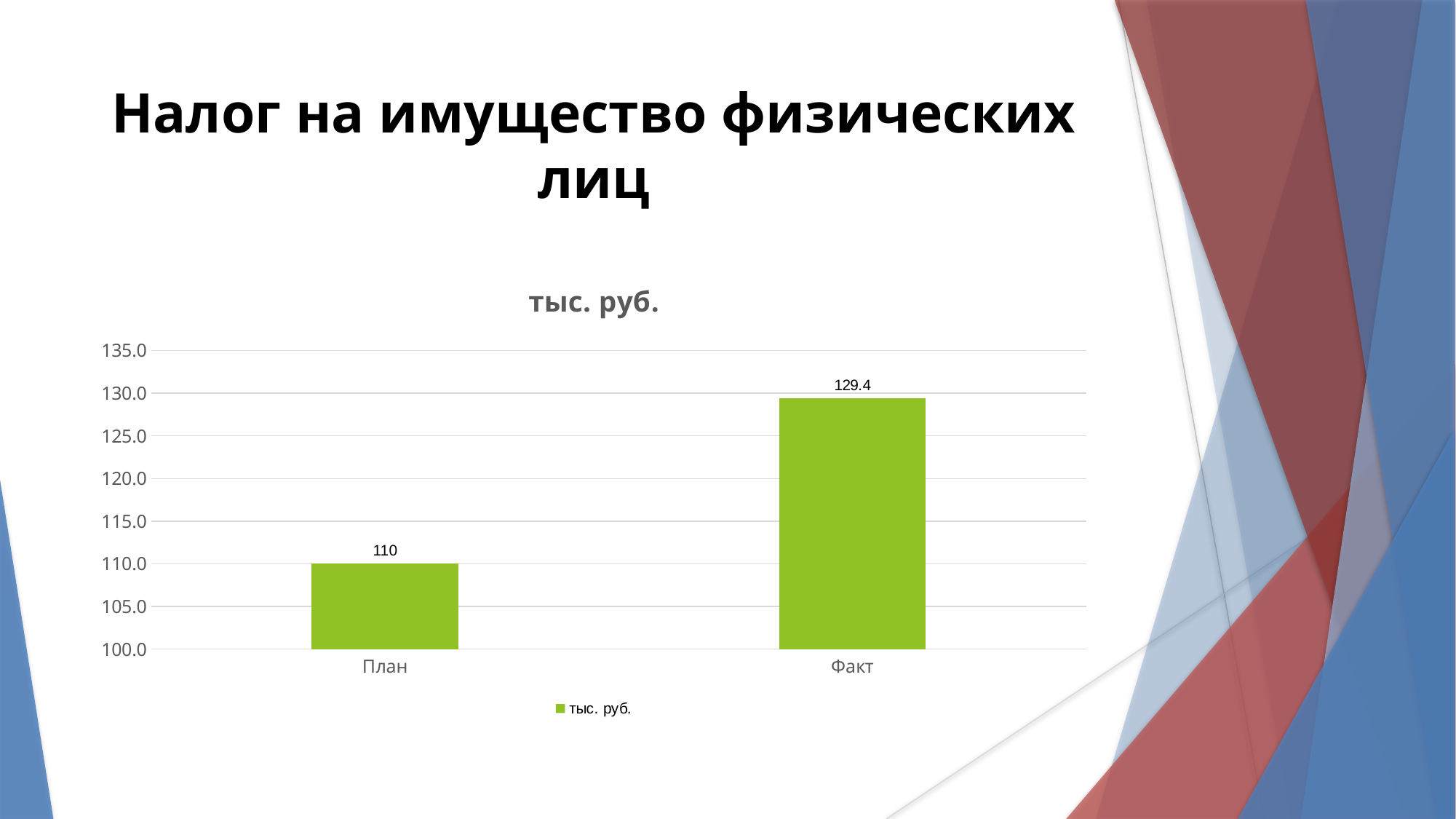
Is the value for Факт greater or less than 125? greater What is the value for План? 110 How many series does the legend list? 1 Which category has the highest value? Факт Which is larger, the value for План or the value for Факт? Факт Is the value for План greater or less than 115? less How many categories are shown on the x axis? 2 What kind of chart is shown? bar chart What is the value for Факт? 129.4 What is the difference between the values for Факт and План? 19.4 Which category has the lowest value? План What is the title of the chart? тыс. руб.